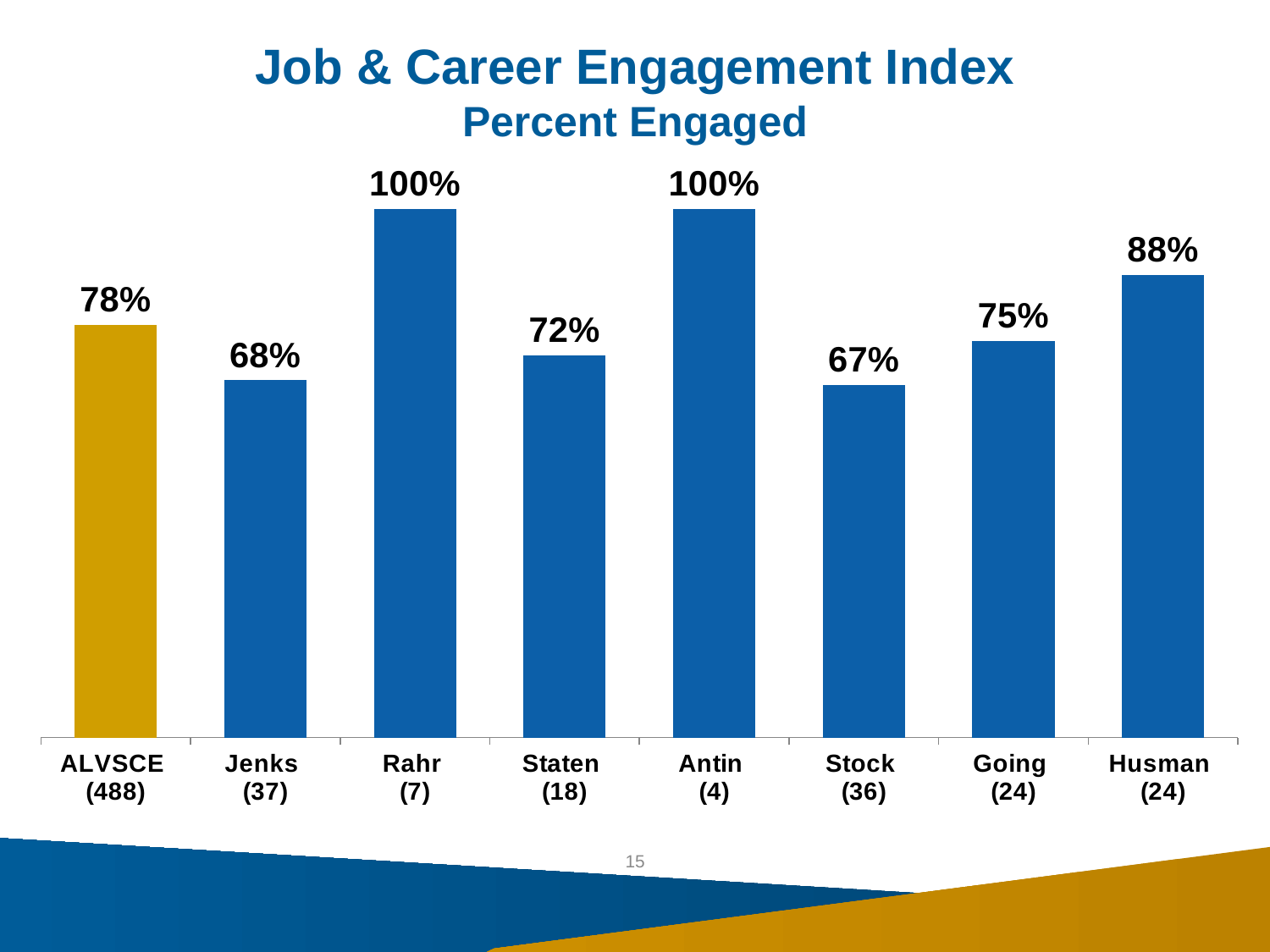
Which bar is coloured differently (gold) from the others? ALVSCE How many categories are shown on the x axis? 8 What is the difference in percent engaged between Husman and Jenks? 20% What is the percent engaged for Husman? 88% What is the percent engaged for ALVSCE? 78% Which two categories share the highest percent engaged at 100%? Rahr and Antin Which category has the lowest percent engaged? Stock What kind of chart is shown on the slide? Bar chart Which has a higher percent engaged, Jenks or Staten? Staten What is the difference in percent engaged between ALVSCE and Going? 3% What is the percent engaged for Staten? 72% What is the title of the chart? Job & Career Engagement Index Percent Engaged